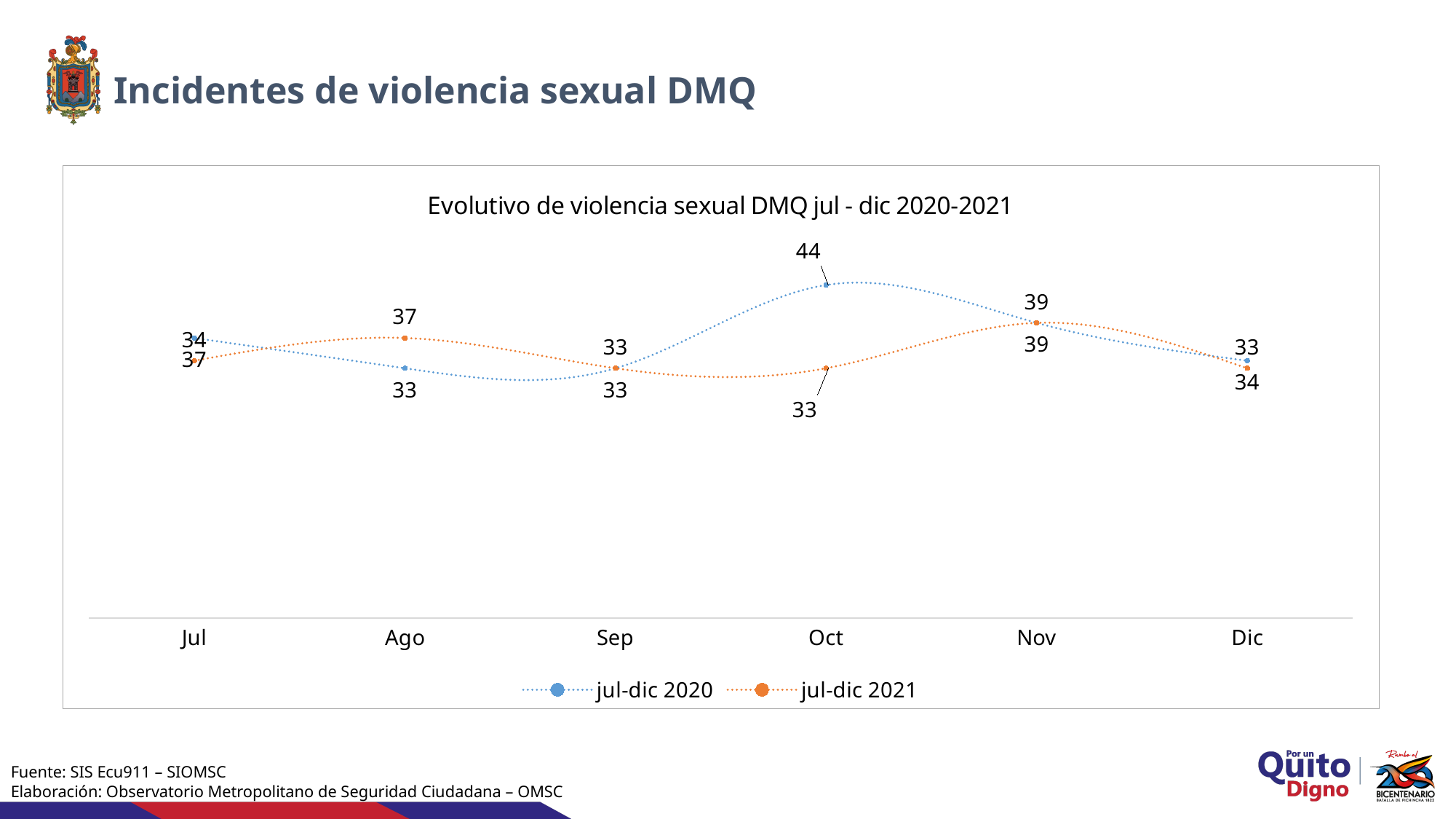
In which month does the jul-dic 2021 series reach its highest value? Nov What is the difference between the jul-dic 2020 and jul-dic 2021 values in Oct? 11 How many months are shown on the x axis? 6 What type of chart is shown on the slide? Line chart What is the value for jul-dic 2021 in Ago? 37 What is the value for jul-dic 2021 in Dic? 33 Which series has the larger value in Ago, jul-dic 2020 or jul-dic 2021? jul-dic 2021 What is the value for jul-dic 2020 in Oct? 44 In which month does the jul-dic 2020 series reach its highest value? Oct What is the title of the chart? Evolutivo de violencia sexual DMQ jul - dic 2020-2021 How does the jul-dic 2020 series change from Oct to Dic? It falls How many series does the legend list? 2